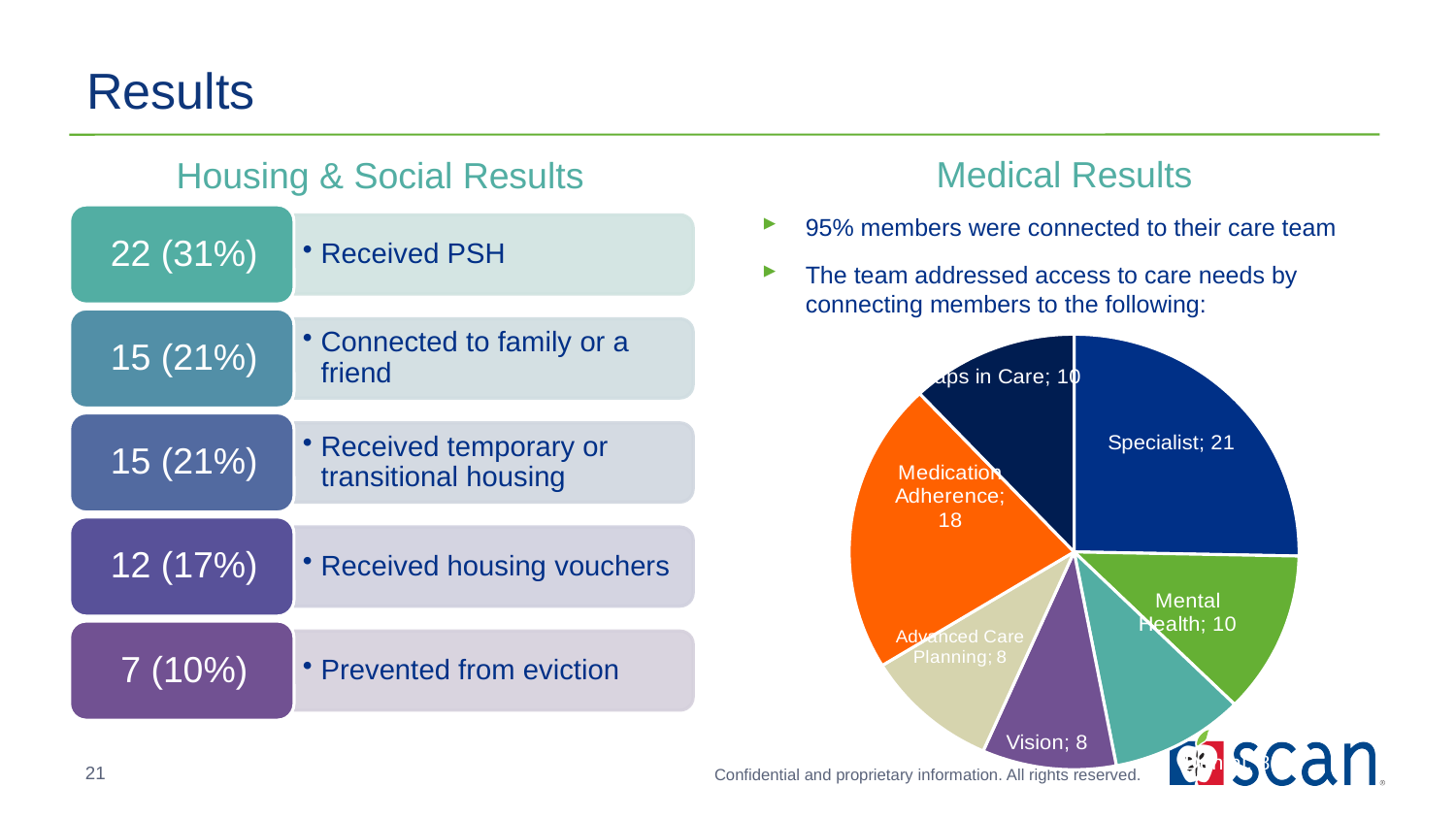
In the Medical Results pie chart, what colour is the Specialist slice? dark blue In the Medical Results pie chart, which is larger, Specialist or Medication Adherence? Specialist In the Medical Results pie chart, what is the difference between the Specialist and Medication Adherence values? 3 In the Medical Results pie chart, what is the value for Advanced Care Planning? 8 In the Medical Results pie chart, what is the value for Medication Adherence? 18 What kind of chart is shown under Medical Results? pie chart In the Medical Results pie chart, which category has the largest slice? Specialist How many slices does the Medical Results pie chart have? 7 In the Medical Results pie chart, what is the value for Mental Health? 10 In the Medical Results pie chart, what is the difference between the Medication Adherence and Mental Health values? 8 In the Medical Results pie chart, what is the value for Vision? 8 In the Medical Results pie chart, what is the value for Specialist? 21